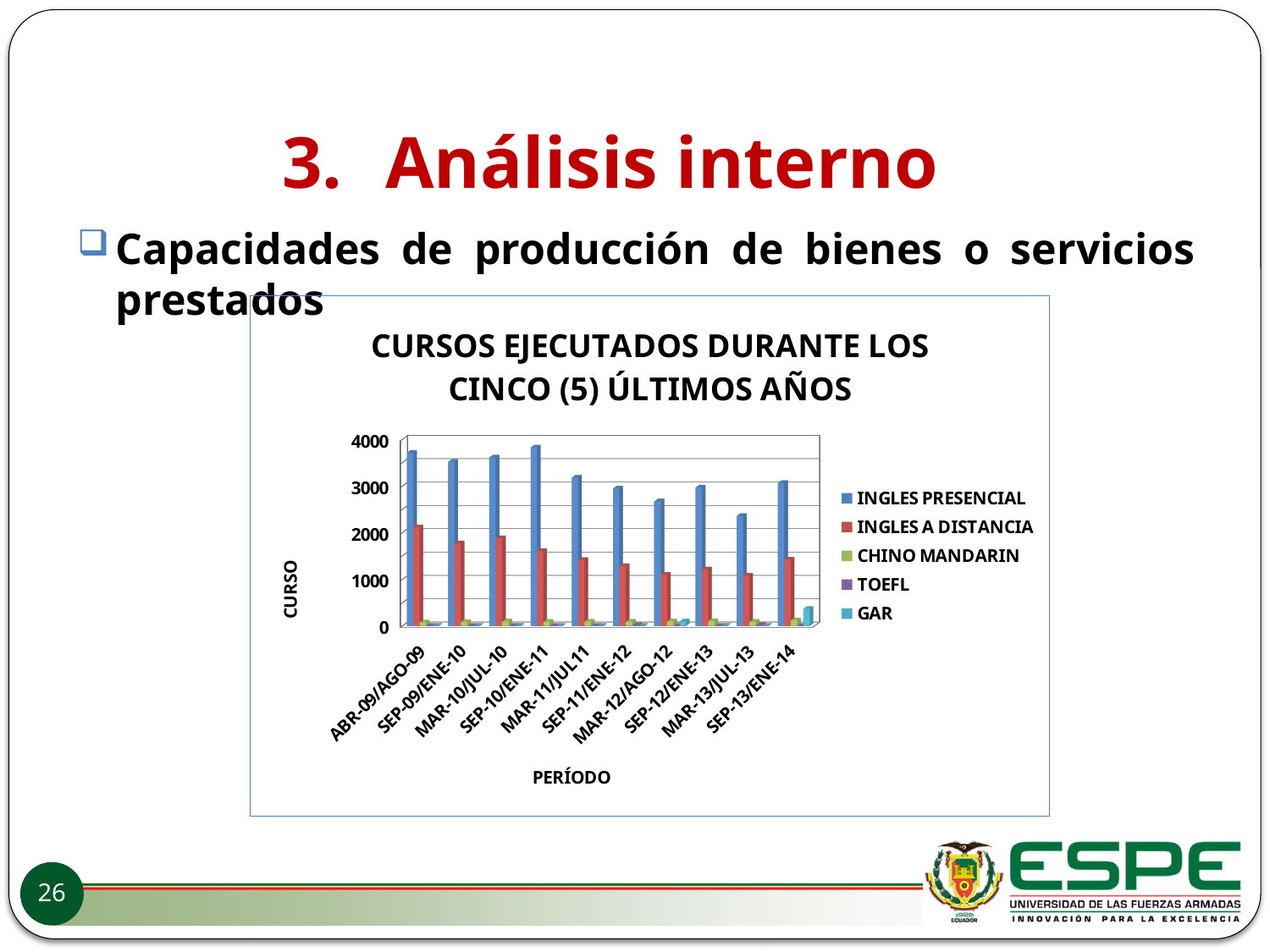
What kind of chart is shown on the slide? Bar chart What is the title of the chart? CURSOS EJECUTADOS DURANTE LOS CINCO (5) ÚLTIMOS AÑOS What is the label of the x axis? PERÍODO In which period is the INGLES PRESENCIAL value the highest? SEP-10/ENE-11 In SEP-13/ENE-14, which is larger: GAR or CHINO MANDARIN? GAR Is the INGLES PRESENCIAL value for MAR-13/JUL-13 greater or less than 3000? less How many series does the legend list? 5 Is the INGLES A DISTANCIA value for SEP-12/ENE-13 greater or less than 2000? less In which period is the INGLES A DISTANCIA value the highest? ABR-09/AGO-09 Is the INGLES PRESENCIAL value for SEP-10/ENE-11 greater or less than 3000? greater How many periods are shown on the x axis? 10 In which period is the INGLES PRESENCIAL value the lowest? MAR-13/JUL-13